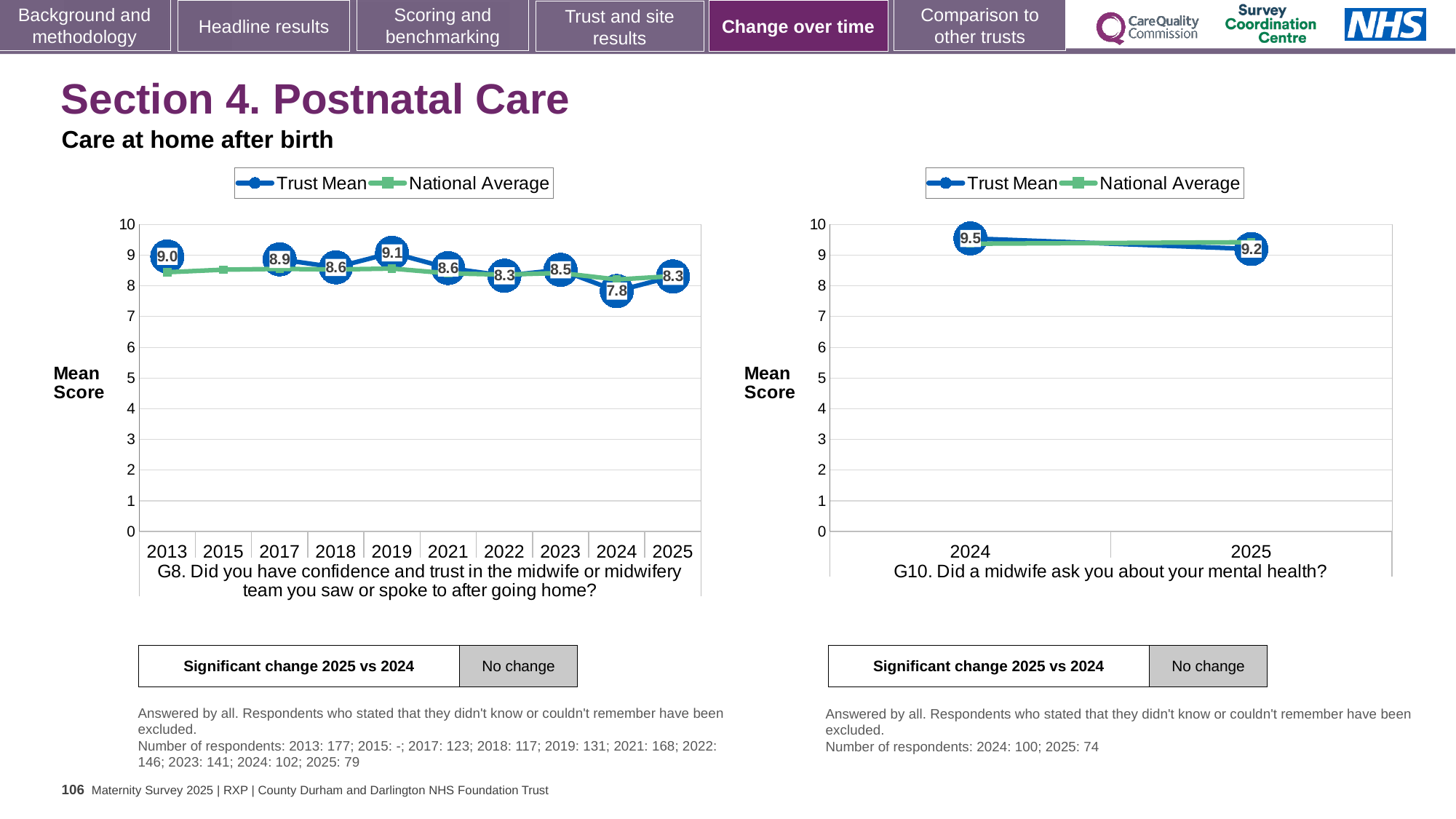
In the G10 chart on the right, what is the difference between the Trust Mean for 2024 and 2025? 0.3 In the G8 chart on the left, what is the Trust Mean for 2024? 7.8 In the G10 chart on the right, what is the Trust Mean for 2025? 9.2 In the G8 chart on the left, is the National Average for 2013 greater or less than 8? greater In the G10 chart on the right, does the Trust Mean rise or fall from 2024 to 2025? fall How many years are shown on the x axis of the G8 chart on the left? 10 In the G8 chart on the left, which year has the lowest Trust Mean? 2024 How many series does the legend of the G10 chart on the right list? 2 In the G8 chart on the left, what is the difference between the Trust Mean for 2025 and 2024? 0.5 In the G8 chart on the left, which year has the highest Trust Mean? 2019 In the G8 chart on the left, what is the Trust Mean for 2019? 9.1 In the G8 chart on the left, is the Trust Mean higher in 2013 or in 2022? 2013